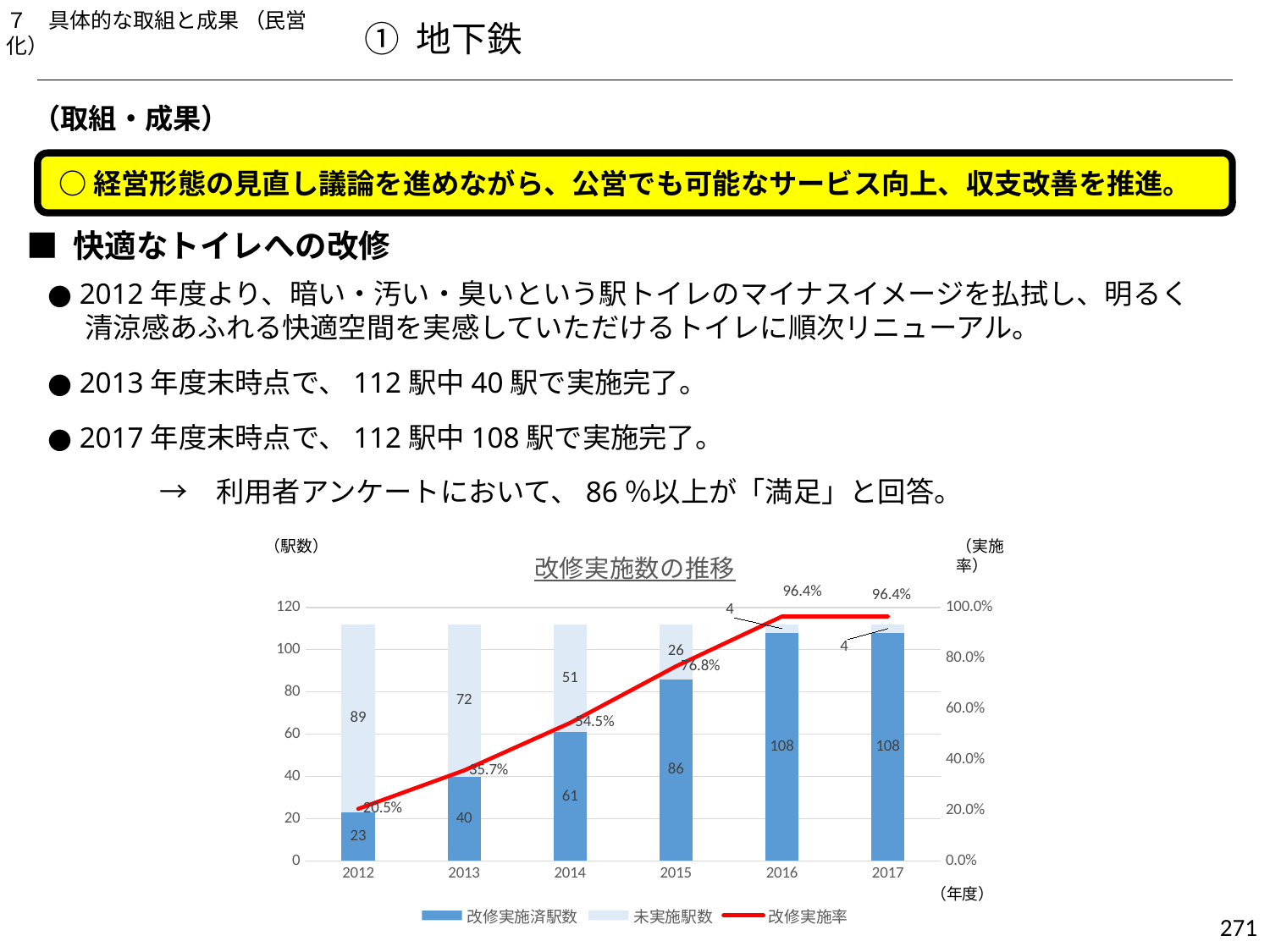
In which year is 未実施駅数 the highest? 2012 In which year is 改修実施済駅数 the lowest? 2012 Does the 改修実施率 line rise or fall from 2012 to 2016? Rise What is the 改修実施率 for 2015? 76.8% What is the difference in 改修実施済駅数 between 2015 and 2013? 46 What is the total of the stacked bar for 2016 (改修実施済駅数 plus 未実施駅数)? 112 What is the value of 改修実施済駅数 for 2014? 61 What is the title of the chart? 改修実施数の推移 How many years (categories) are shown on the x axis of the chart? 6 How many series does the chart legend list? 3 What type of chart is shown on the slide? Stacked bar chart with a line What is the value of 未実施駅数 for 2013? 72